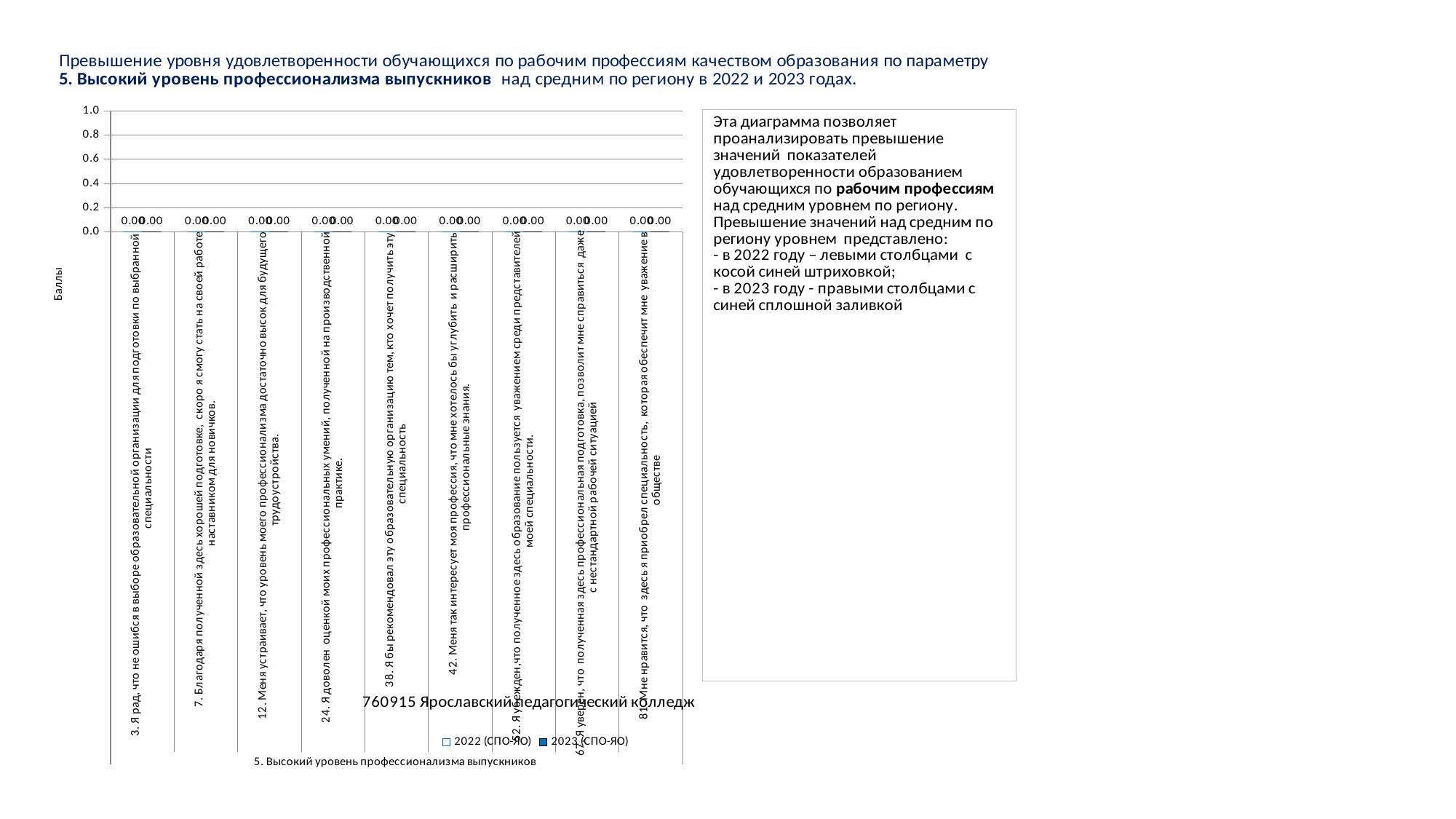
What are the two series named in the chart legend? 2022 (СПО-ЯО) and 2023 (СПО-ЯО) How many categories (statements) are plotted along the x axis of the chart? 9 What is the highest value shown on the vertical axis of the chart? 1.0 What is the label of the vertical axis of the chart? Баллы What is the difference between the 2022 (СПО-ЯО) and 2023 (СПО-ЯО) values for the category '24. Я доволен оценкой моих профессиональных умений, полученной на производственной практике.'? 0.00 What is the value for 2022 (СПО-ЯО) for the category '3. Я рад, что не ошибся в выборе образовательной организации для подготовки по выбранной специальности'? 0.00 How many series does the chart legend list? 2 What is the value for 2023 (СПО-ЯО) for the category '12. Меня устраивает, что уровень моего профессионализма достаточно высок для будущего трудоустройства.'? 0.00 What is the value for 2023 (СПО-ЯО) for the category '42. Меня так интересует моя профессия, что мне хотелось бы углубить и расширить профессиональные знания.'? 0.00 What is the value for 2022 (СПО-ЯО) for the category '38. Я бы рекомендовал эту образовательную организацию тем, кто хочет получить эту специальность'? 0.00 What kind of chart is shown on the slide? bar chart Is the value for 2022 (СПО-ЯО) for the category '7. Благодаря полученной здесь хорошей подготовке, скоро я смогу стать на своей работе наставником для новичков.' greater or less than 0.2? less